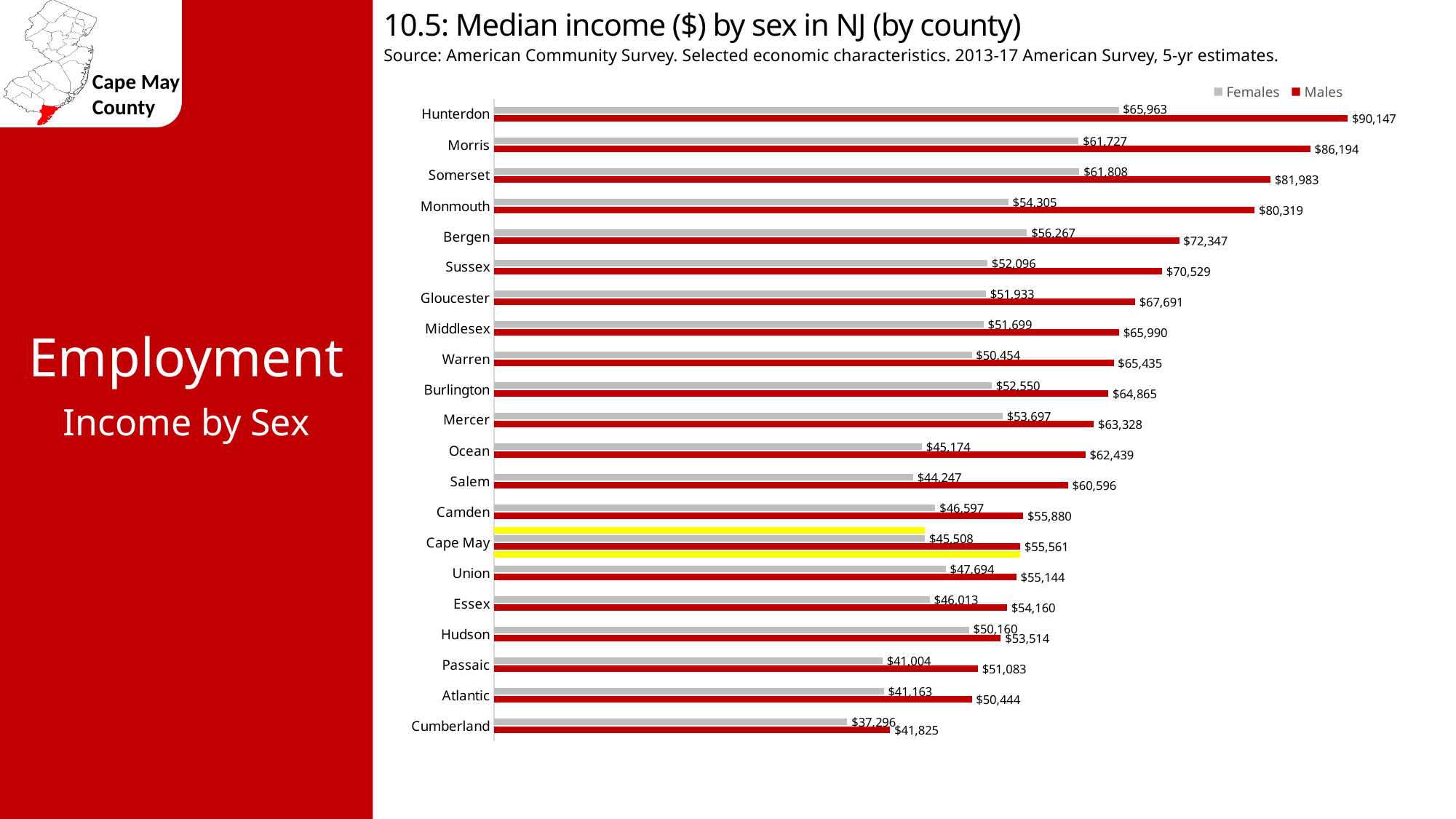
What is the median income for females in Cape May County? $45,508 How many counties are shown in the chart? 21 What is the difference between the male and female median incomes in Hunterdon County? $24,184 What is the median income for males in Cape May County? $55,561 Which is larger, the female median income in Bergen or in Monmouth? Bergen Which county has the highest median income for males? Hunterdon What is the difference between the male and female median incomes in Cape May County? $10,053 Which county's bars are highlighted in yellow on the chart? Cape May What is the median income for males in Cumberland County? $41,825 Which county has the lowest median income for females? Cumberland What kind of chart is shown on the slide? Bar chart How many series does the legend list? 2